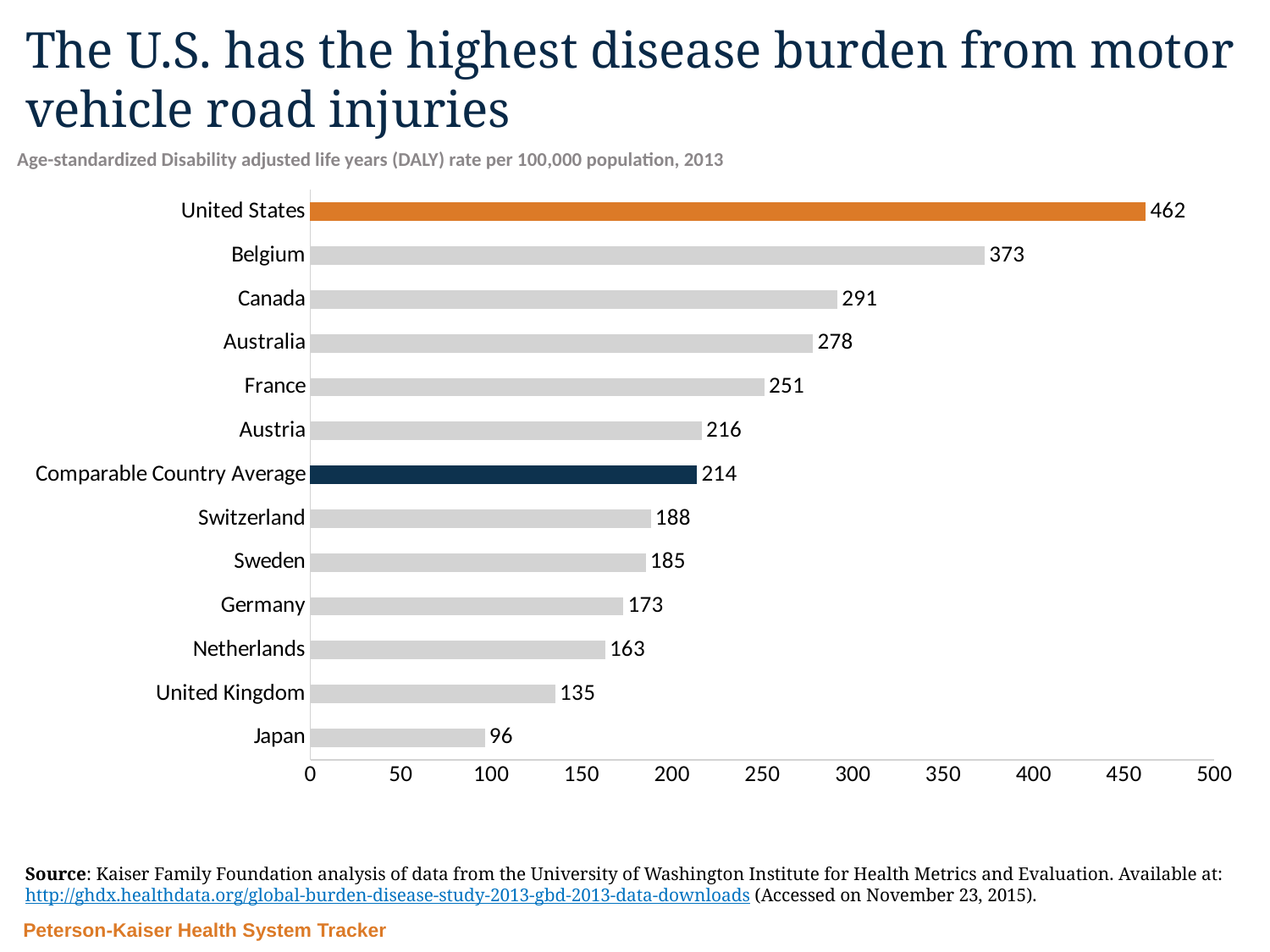
What is the difference between the United States value and the Comparable Country Average? 248 Which bar is coloured orange? United States Which has a higher DALY rate, France or Australia? Australia What is the DALY rate for the United States? 462 What type of chart is shown on the slide? Bar chart How many bars are shown on the chart? 13 What is the DALY rate for Japan? 96 What is the value shown for the Comparable Country Average? 214 How much higher is Belgium's value than Canada's? 82 Which country has the highest DALY rate from motor vehicle road injuries? United States Is the value for the United Kingdom greater or less than 150? less Which country has the lowest DALY rate on the chart? Japan